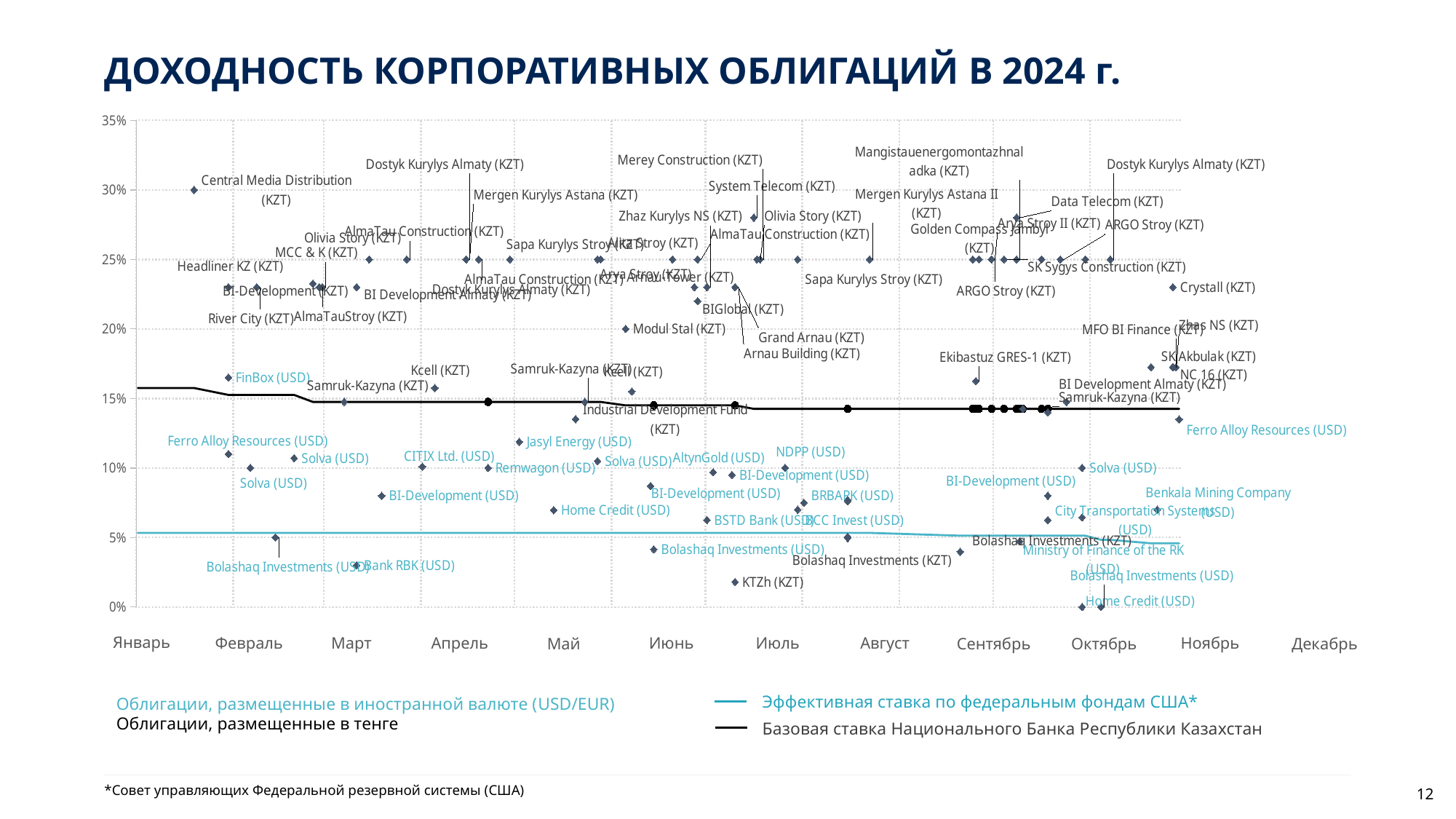
Which is higher, the yield of Central Media Distribution (KZT) or Modul Stal (KZT)? Central Media Distribution (KZT) Is the yield for Ekibastuz GRES-1 (KZT) greater or less than 15%? greater What is the yield for Modul Stal (KZT)? 20% How many entries does the legend list? 4 What is the title of the chart? ДОХОДНОСТЬ КОРПОРАТИВНЫХ ОБЛИГАЦИЙ В 2024 г. What kind of chart is shown on the slide? line chart Does the line for the base rate of the National Bank of Kazakhstan (Базовая ставка) rise or fall over the year? fall Is the yield for Crystall (KZT) greater or less than 20%? greater What is the difference between the yields of Central Media Distribution (KZT) and Modul Stal (KZT)? 10% Which bond has the highest yield on the chart? Central Media Distribution (KZT) Is the yield for KTZh (KZT) greater or less than 5%? less What is the yield for Central Media Distribution (KZT)? 30%